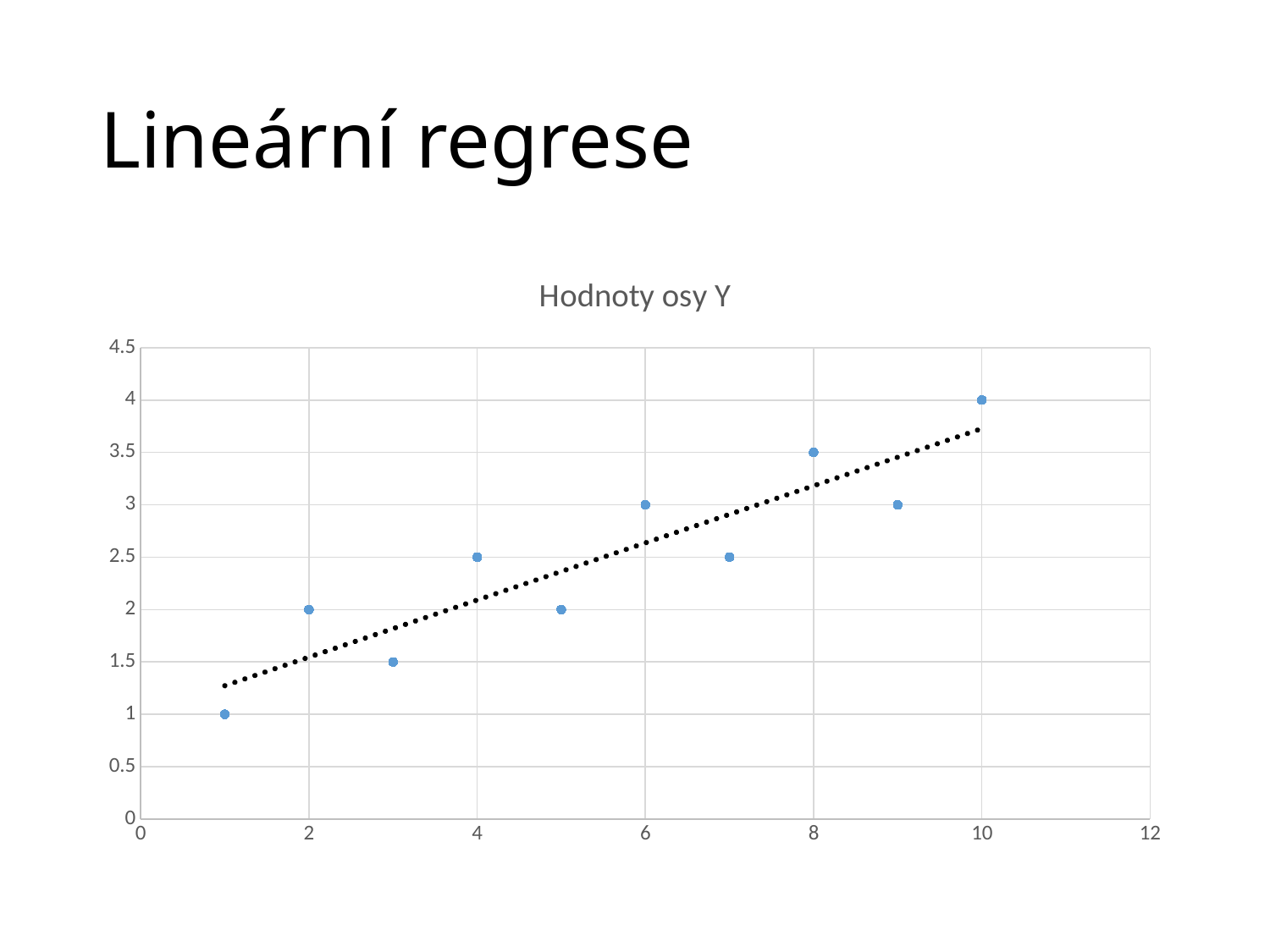
Do the y values generally rise or fall as x increases? rise What kind of chart is shown on the slide? scatter chart What is the y value of the point at x = 3? 1.5 At which x value is the lowest y value plotted? 1 At which x value is the highest y value plotted? 10 What is the y value of the point at x = 1? 1 What is the title of the chart? Hodnoty osy Y What is the difference between the y values at x = 10 and x = 1? 3 Which has the larger y value, the point at x = 6 or the point at x = 7? x = 6 What is the y value of the point at x = 8? 3.5 What is the y value of the point at x = 10? 4 How many data points are plotted in the chart? 10